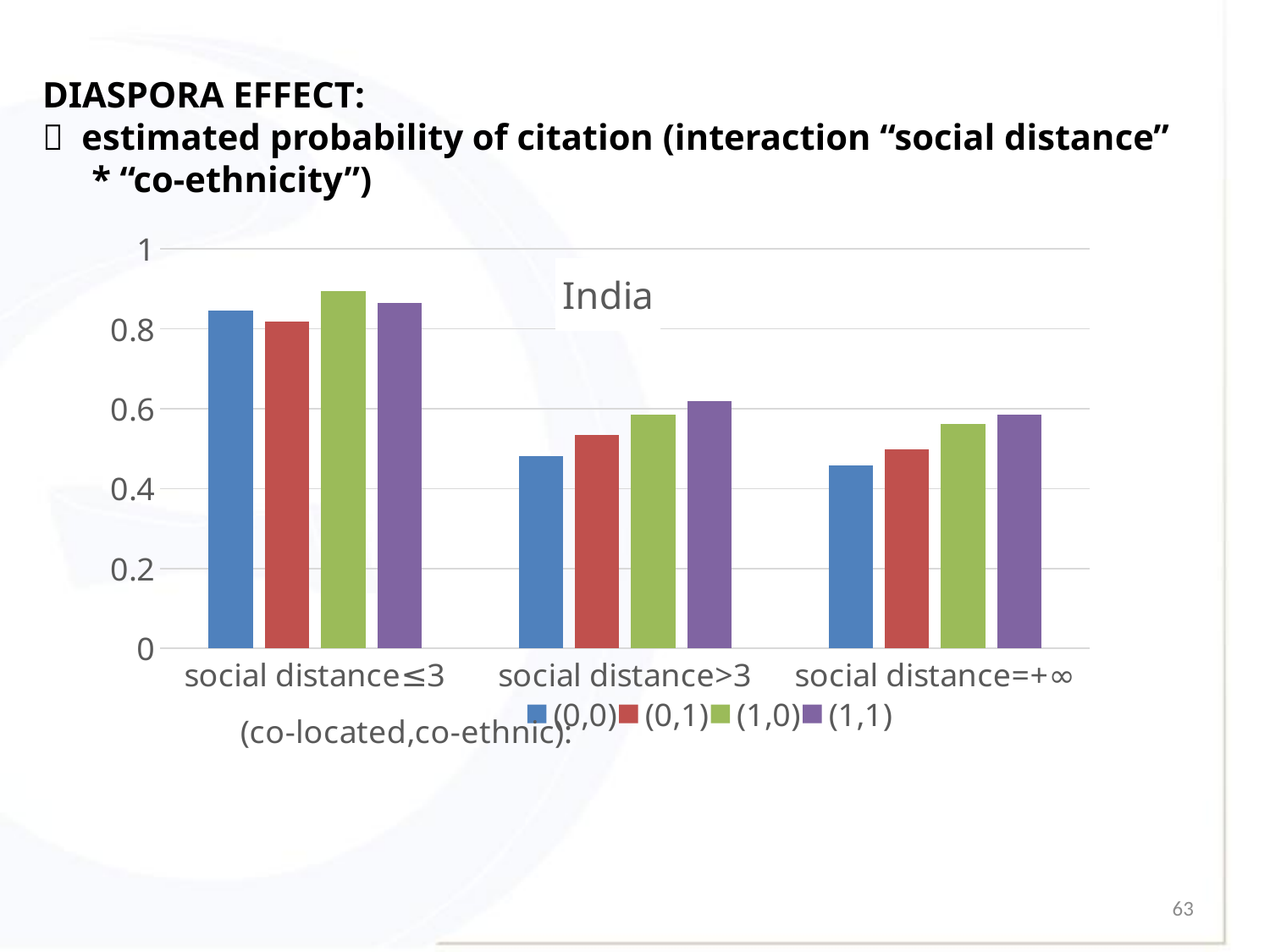
Which series has the lowest value in the 'social distance=+∞' category? (0,0) What is the title of the chart? India Do the values for the (0,0) series rise or fall from 'social distance≤3' to 'social distance=+∞'? fall How many categories are shown on the x axis of the chart? 3 Is the value for (1,1) in the 'social distance=+∞' category greater or less than 0.4? greater How many series does the chart's legend list? 4 In the 'social distance>3' category, which is larger: the value for (0,0) or the value for (1,1)? (1,1) What kind of chart is shown on the slide? bar chart Which series is shown in green in the legend? (1,0) Is the value for (0,0) in the 'social distance>3' category greater or less than 0.6? less Which category has the highest value for the (1,0) series? social distance≤3 Is the value for (0,0) in the 'social distance≤3' category greater or less than 0.8? greater